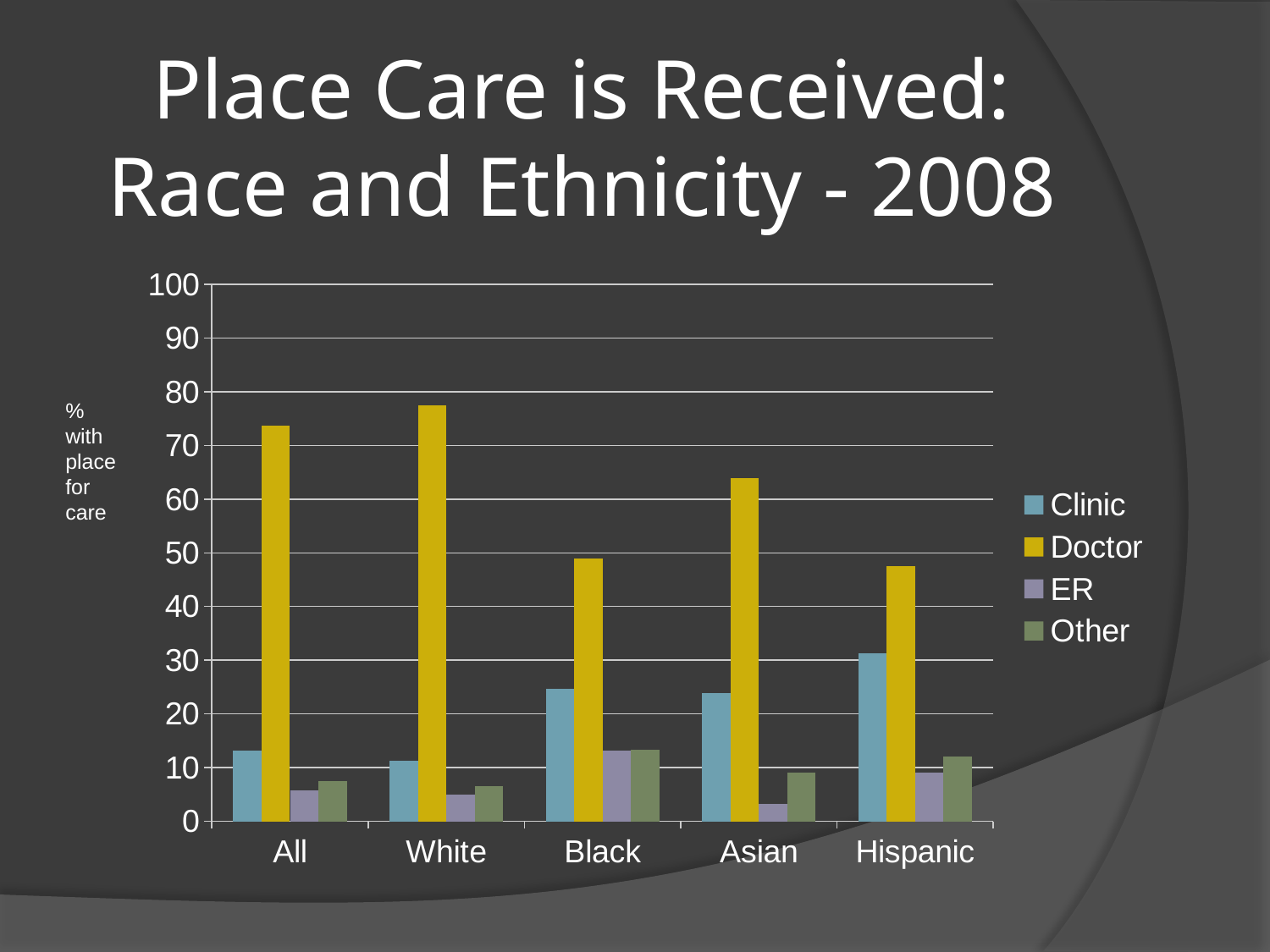
How many series does the legend list? 4 Is the ER value for White greater or less than 10? less What kind of chart is shown on the slide? bar chart Which group has the highest Clinic value? Hispanic For Black, which is larger, the Clinic value or the ER value? Clinic Which is larger, the Doctor value for White or the Doctor value for Asian? White Which group has the highest Doctor value? White How many race/ethnicity categories are shown on the x axis? 5 What is the label on the y axis? % with place for care Is the Doctor value for All greater or less than 70? greater Is the Doctor value for Asian greater or less than 60? greater Which group has the lowest ER value? Asian